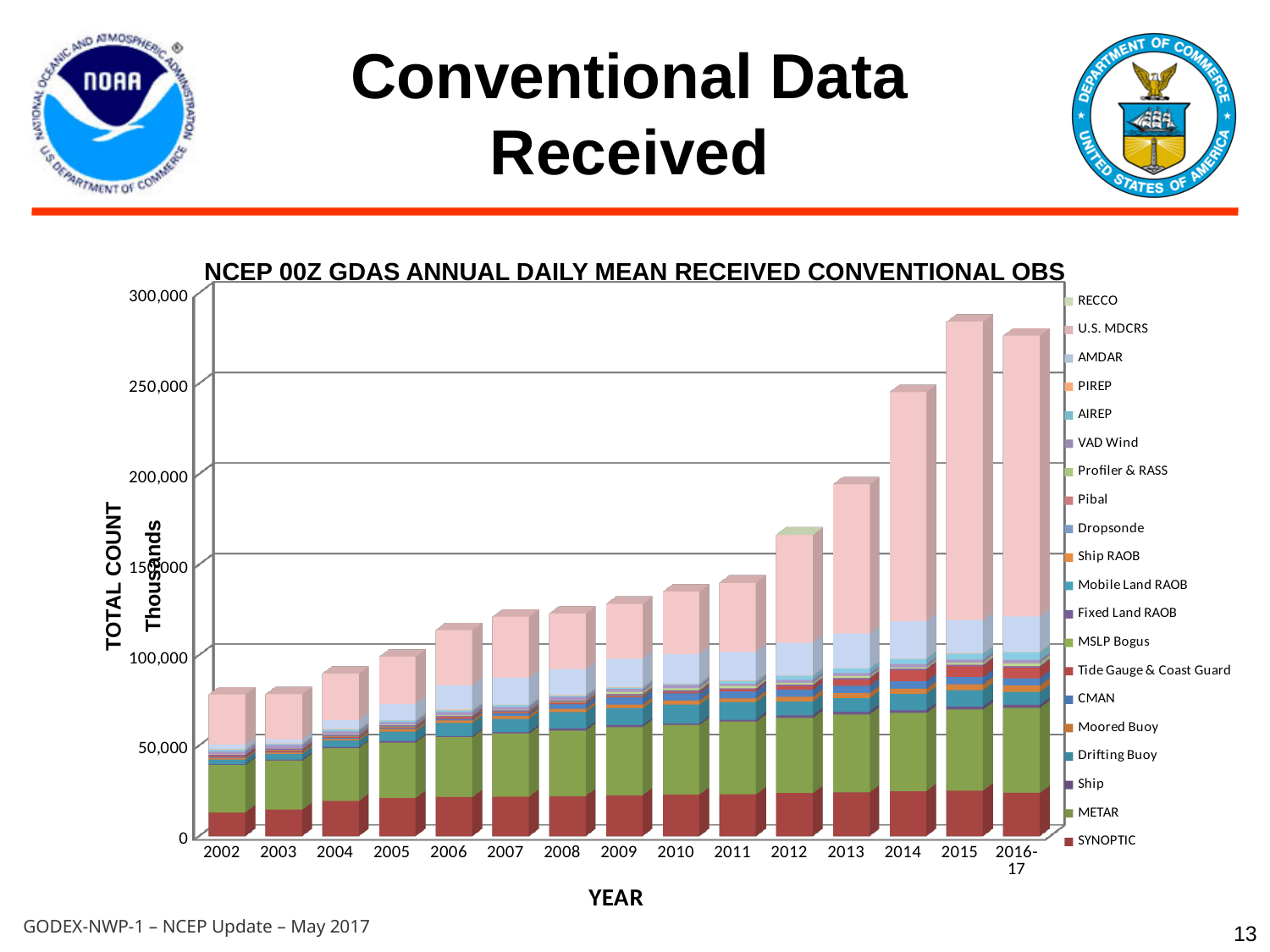
How many years (categories) are shown along the x axis? 15 Is the total count for 2015 greater or less than 250,000? greater Is the total count for 2010 greater or less than 150,000? less Which year has the highest total count? 2015 Is the total count for 2012 greater or less than 150,000? greater What is the title of the chart? NCEP 00Z GDAS ANNUAL DAILY MEAN RECEIVED CONVENTIONAL OBS Which year has the larger total count, 2011 or 2012? 2012 How many series does the legend list? 20 What is the label on the x axis? YEAR Do the total counts generally rise or fall from 2002 to 2015? rise What kind of chart is shown on the slide? stacked bar chart